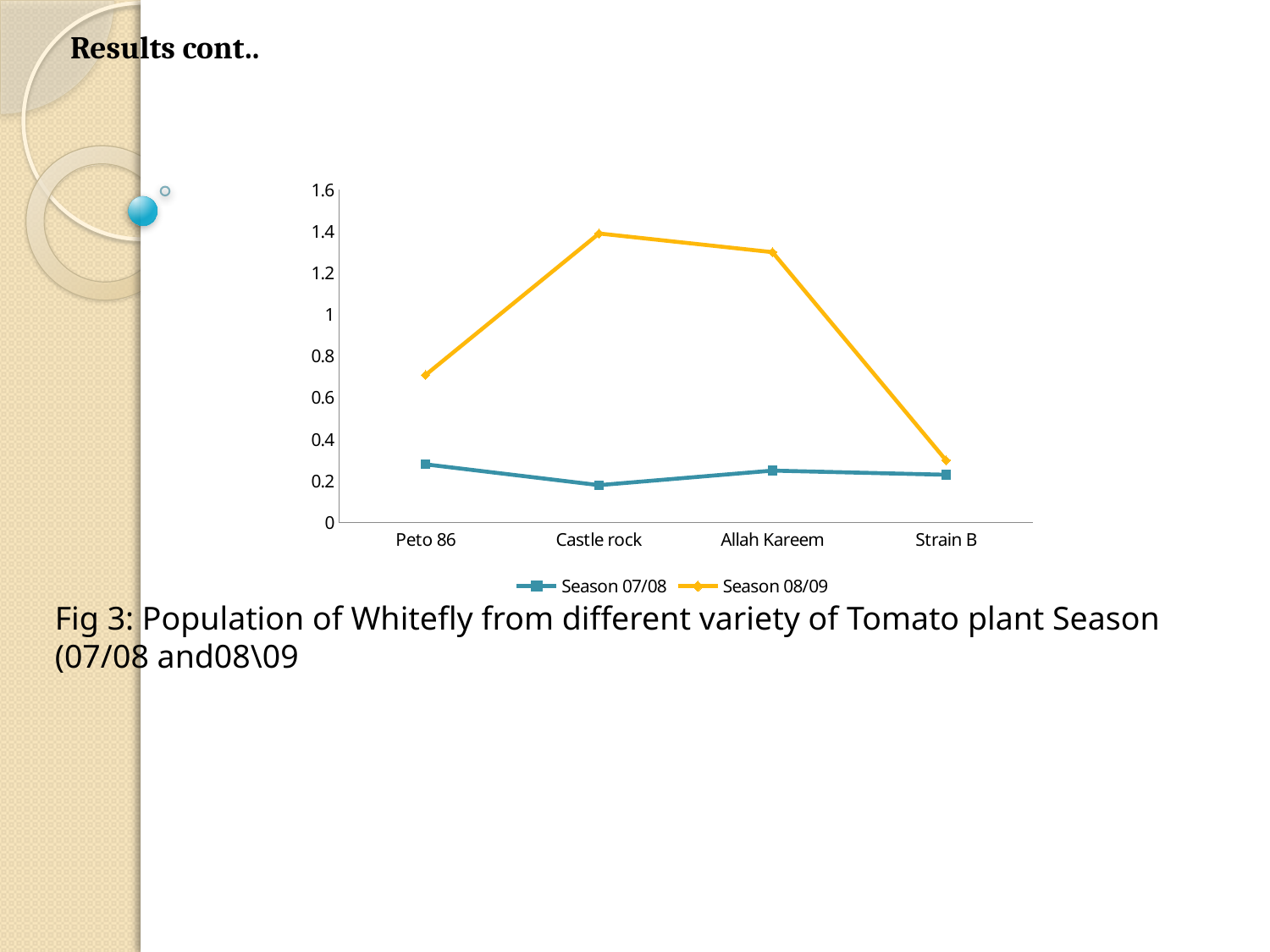
Does the Season 08/09 line rise or fall from Allah Kareem to Strain B? fall Which variety has the lowest value for Season 08/09? Strain B Is the Season 07/08 value for Castle rock greater or less than 0.4? less How many series does the legend list? 2 Is the Season 08/09 value for Castle rock greater or less than 1.2? greater Is the Season 08/09 value for Allah Kareem greater or less than 1? greater Which variety has the highest value for Season 08/09? Castle rock How many tomato varieties are shown on the x axis? 4 What kind of chart is shown on the slide? line chart At Castle rock, which series has the larger value, Season 07/08 or Season 08/09? Season 08/09 What is the figure caption below the chart? Fig 3: Population of Whitefly from different variety of Tomato plant Season (07/08 and08\09